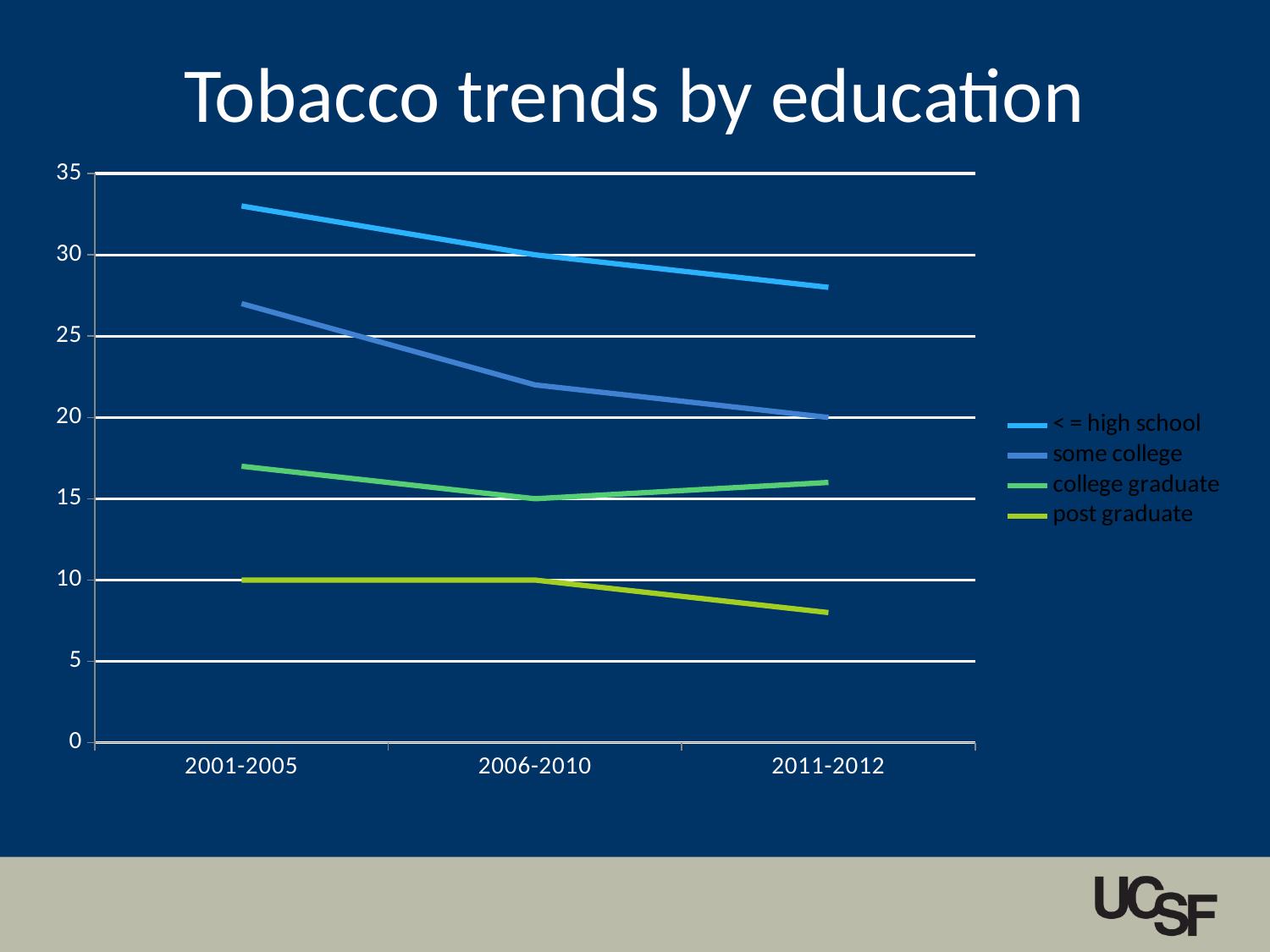
Is the value for post graduate in 2011-2012 greater or less than 10? less Which education group has the highest value in 2001-2005? < = high school Does the < = high school line rise or fall from 2001-2005 to 2011-2012? fall How many series does the legend list? 4 What is the value for college graduate in 2006-2010? 15 What is the value for some college in 2011-2012? 20 What is the title of the chart? Tobacco trends by education How many time periods are shown on the x axis? 3 What is the value for post graduate in 2001-2005? 10 Which education group has the lowest value in 2011-2012? post graduate What kind of chart is shown on the slide? line chart Is the value for < = high school in 2011-2012 greater or less than 25? greater